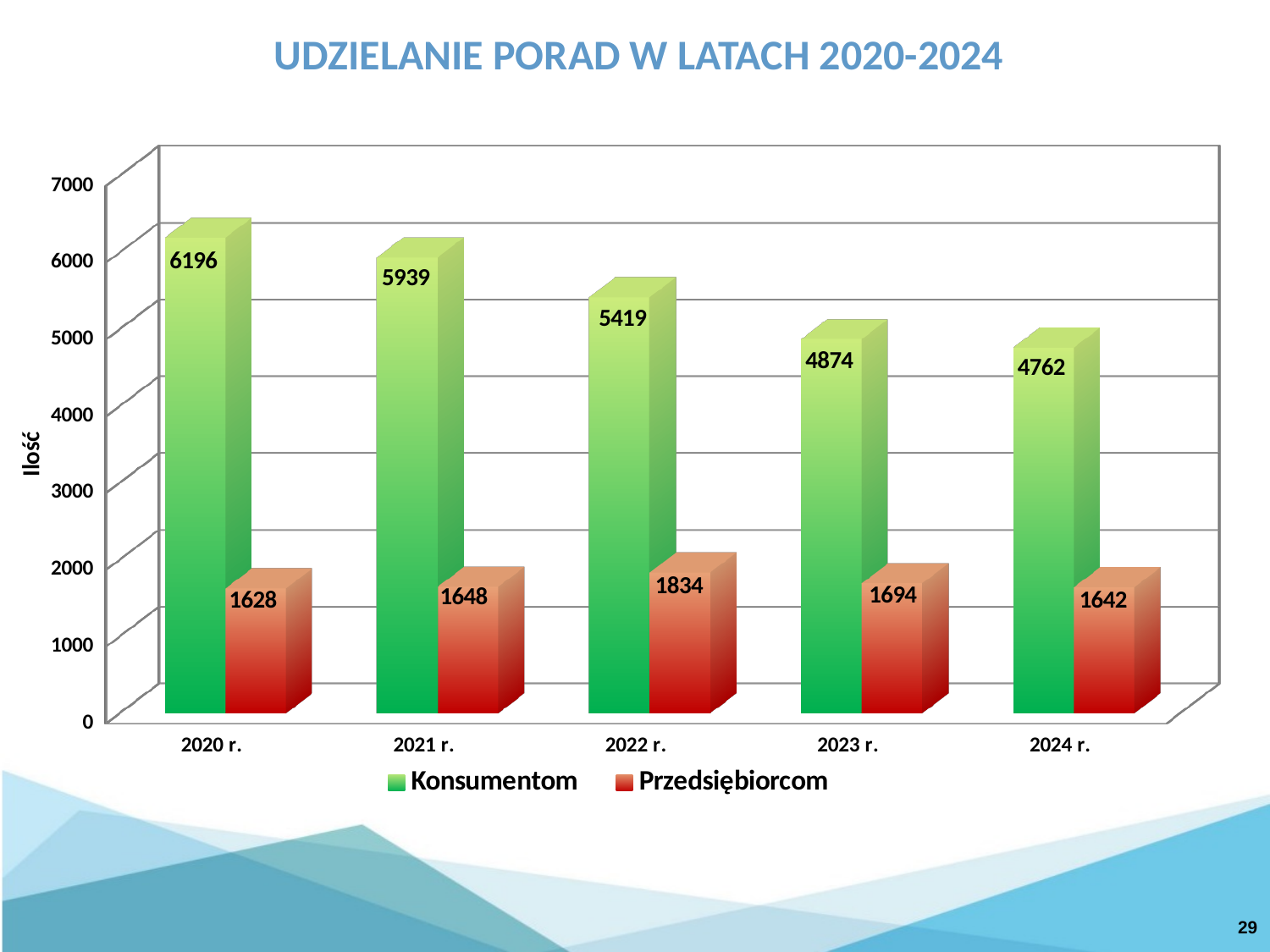
What is the difference between the Konsumentom values for 2020 r. and 2024 r.? 1434 What is the value for Konsumentom in 2020 r.? 6196 How many years are shown on the x axis? 5 What is the value for Przedsiębiorcom in 2022 r.? 1834 What is the title of the chart? UDZIELANIE PORAD W LATACH 2020-2024 Which is larger: the Przedsiębiorcom value in 2022 r. or in 2023 r.? 2022 r. How many series does the legend list? 2 What is the value for Konsumentom in 2024 r.? 4762 What kind of chart is shown on the slide? bar chart Do the Konsumentom values rise or fall from 2020 r. to 2024 r.? fall In which year is the Przedsiębiorcom value lowest? 2020 r. In which year is the Konsumentom value highest? 2020 r.